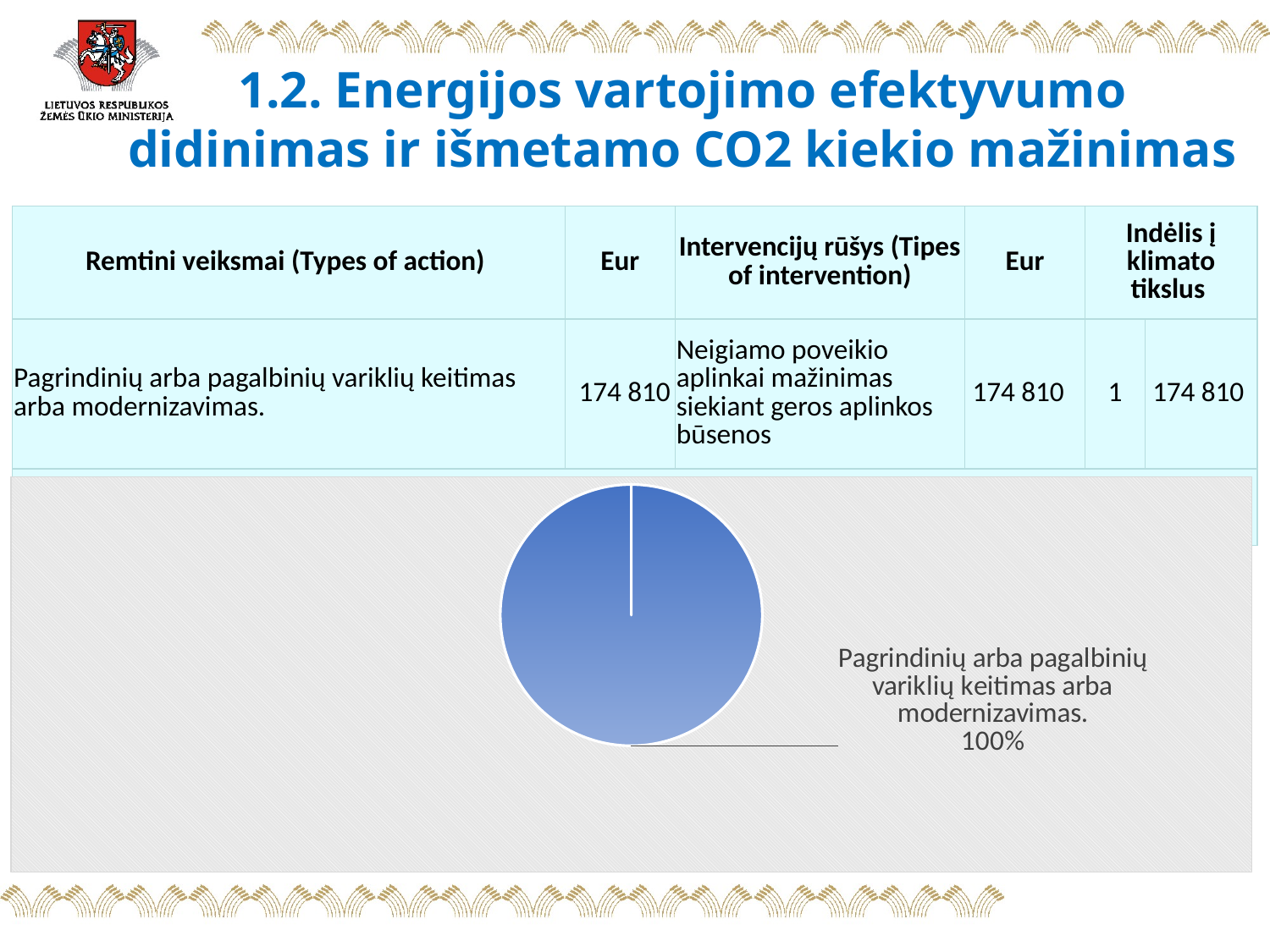
How many slices does the pie chart have? 1 What colour is the single slice of the pie chart? blue What is the percentage printed on the data label of the pie chart? 100% What share of the pie does the slice "Pagrindinių arba pagalbinių variklių keitimas arba modernizavimas." represent? 100% Which category is labelled on the pie chart? Pagrindinių arba pagalbinių variklių keitimas arba modernizavimas. What kind of chart is shown on the slide? pie chart